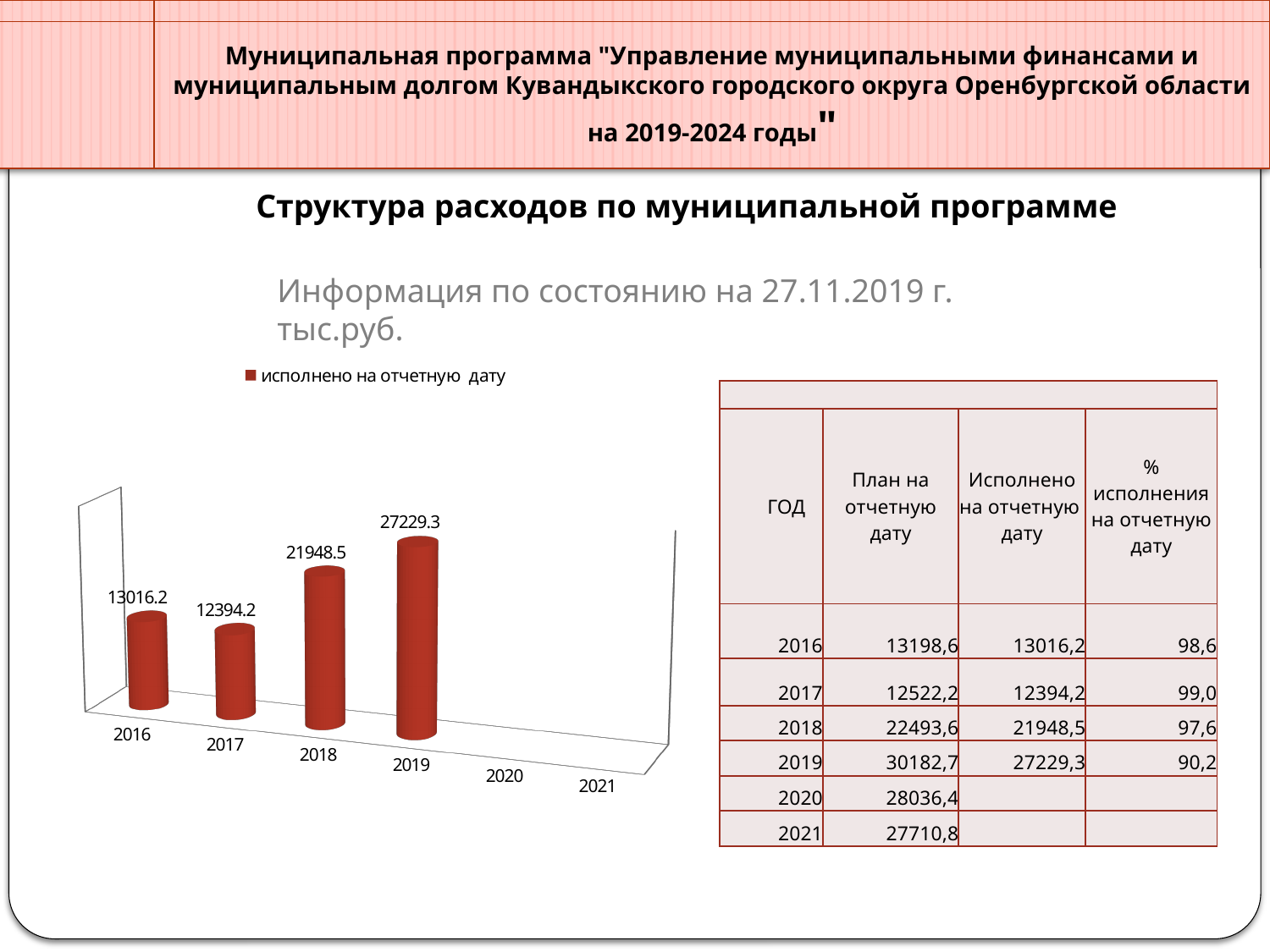
How many bars are plotted in the chart? 4 What is the value plotted for 2017 in the chart? 12394.2 What is the value plotted for 2016 in the chart? 13016.2 What kind of chart is shown on the slide? bar chart Do the values in the chart rise or fall from 2017 to 2019? rise Which is larger in the chart, the value for 2018 or the value for 2016? 2018 What is the difference between the values for 2019 and 2018 in the chart? 5280.8 What is the value plotted for 2018 in the chart? 21948.5 What is the difference between the values for 2016 and 2017 in the chart? 622.0 What is the value plotted for 2019 in the chart? 27229.3 Which year has the highest bar in the chart? 2019 Which year has the lowest bar in the chart? 2017